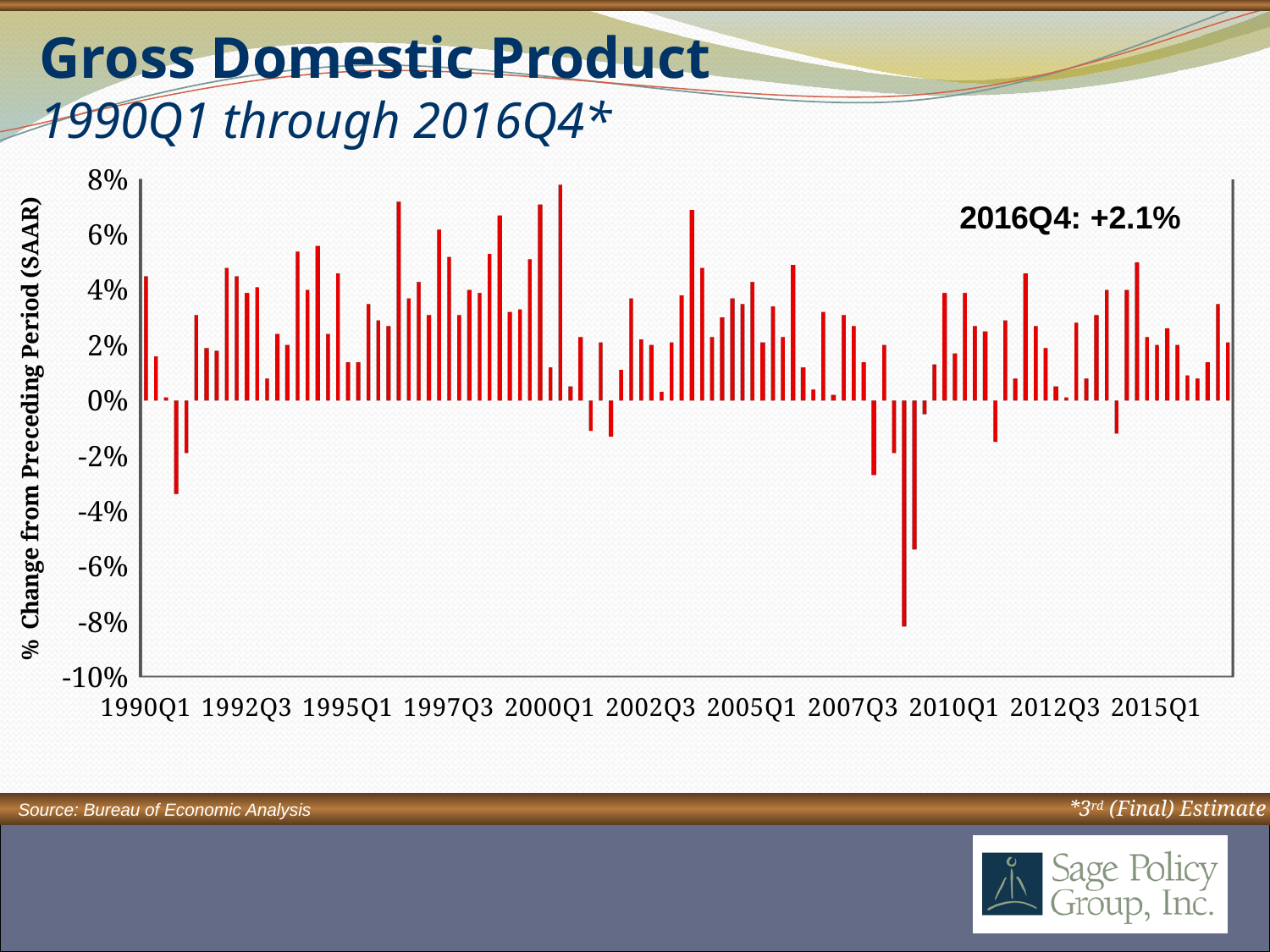
Is the lowest bar on the chart greater or less than -6%? less Is the value for 2016Q4 greater or less than 4%? less What is the lowest value shown on the y axis? -10% Is the highest bar on the chart greater or less than 6%? greater What is the value shown for 2016Q4? +2.1% What is the title of the chart on the slide? Gross Domestic Product 1990Q1 through 2016Q4* How many period labels are shown along the x axis? 11 What is the highest value shown on the y axis? 8% What colour are the bars in the chart? red How many data series are plotted in the chart? 1 What kind of chart is shown on the slide? bar chart Is the lowest value on the chart positive or negative? negative